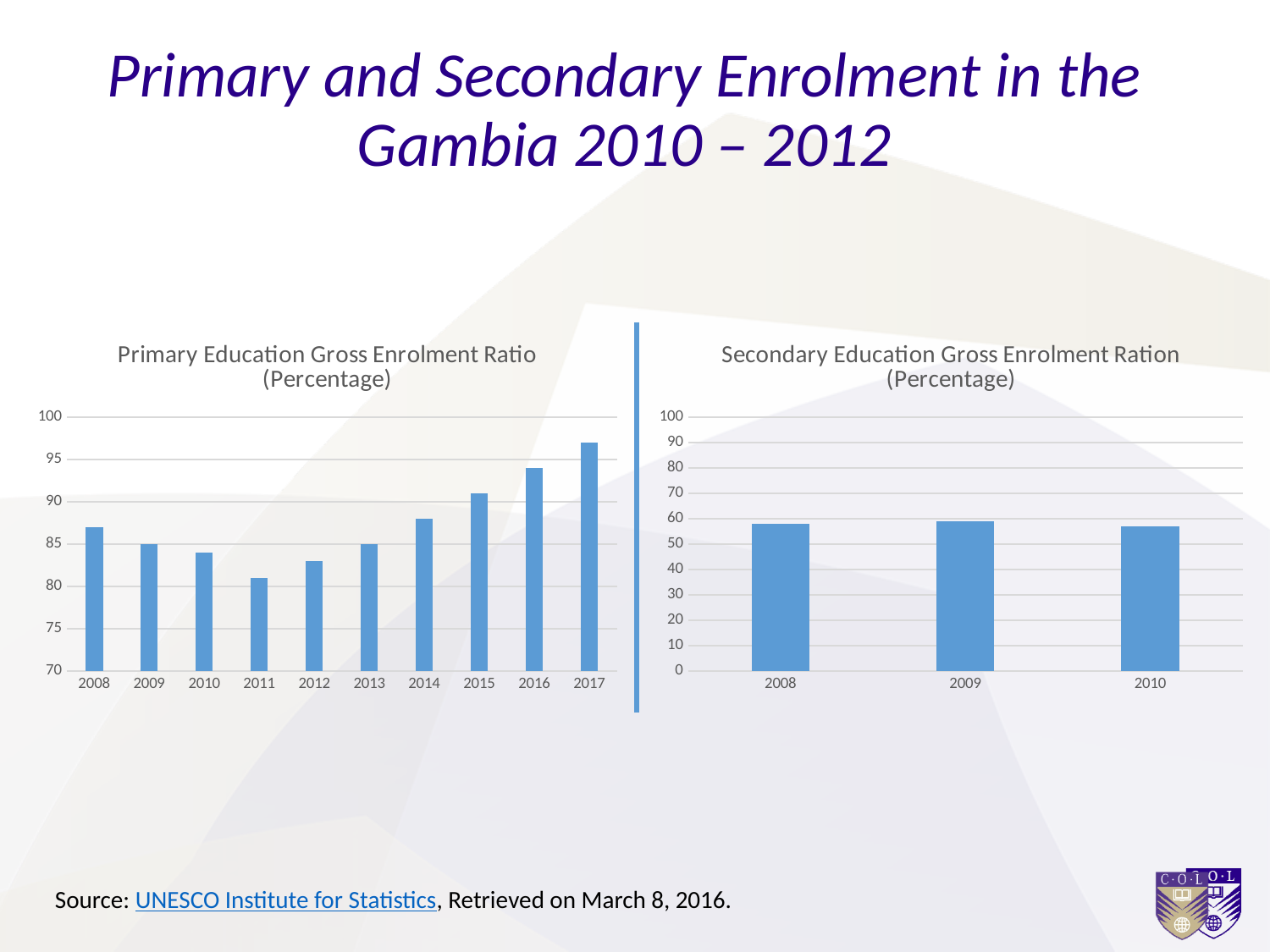
On the Primary Education Gross Enrolment Ratio chart, do the values rise or fall from 2011 to 2017? rise On the Primary Education Gross Enrolment Ratio chart, which is larger, the value for 2008 or the value for 2017? 2017 On the Primary Education Gross Enrolment Ratio chart, is the value for 2014 greater or less than 85? greater On the Secondary Education Gross Enrolment Ration chart, is the value for 2008 greater or less than 50? greater On the Primary Education Gross Enrolment Ratio chart, is the value for 2011 greater or less than 85? less On the Primary Education Gross Enrolment Ratio chart, which year has the highest value? 2017 How many years are shown on the Primary Education Gross Enrolment Ratio chart? 10 On the Primary Education Gross Enrolment Ratio chart, which year has the lowest value? 2011 What is the title of the chart on the right side of the slide? Secondary Education Gross Enrolment Ration (Percentage) How many years are shown on the Secondary Education Gross Enrolment Ration chart? 3 What kind of chart is the Primary Education Gross Enrolment Ratio chart? bar chart